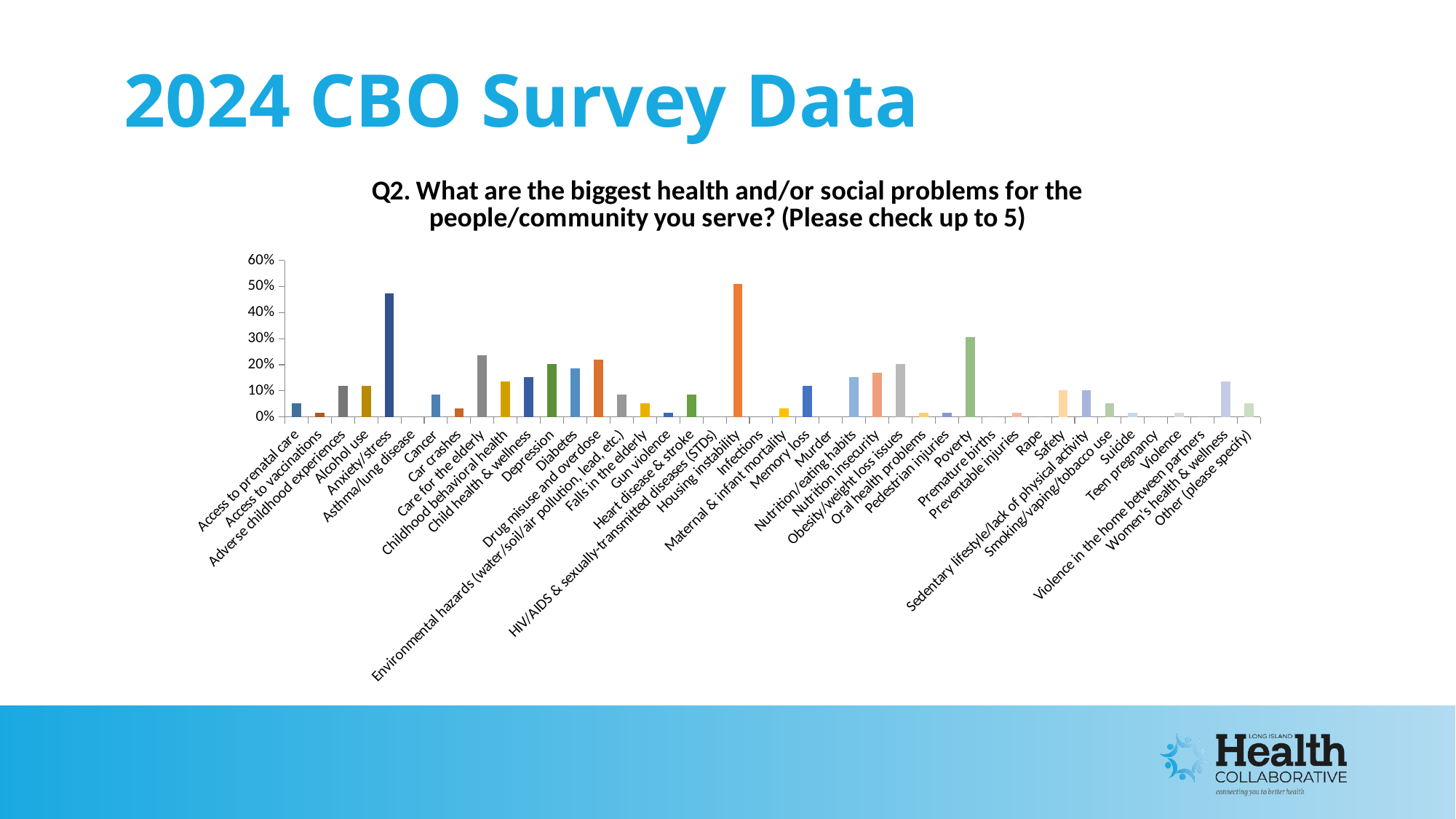
What kind of chart is shown on the slide? bar chart What is the highest value shown on the vertical axis of the chart? 60% Is the value for Poverty greater or less than 20%? greater Is the value for Women's health & wellness greater or less than 10%? greater Is the value for Access to prenatal care greater or less than 10%? less Which is larger, the value for Care for the elderly or the value for Diabetes? Care for the elderly Which is larger, the value for Poverty or the value for Drug misuse and overdose? Poverty Which is larger, the value for Anxiety/stress or the value for Poverty? Anxiety/stress Which category has the highest value in the chart? Housing instability